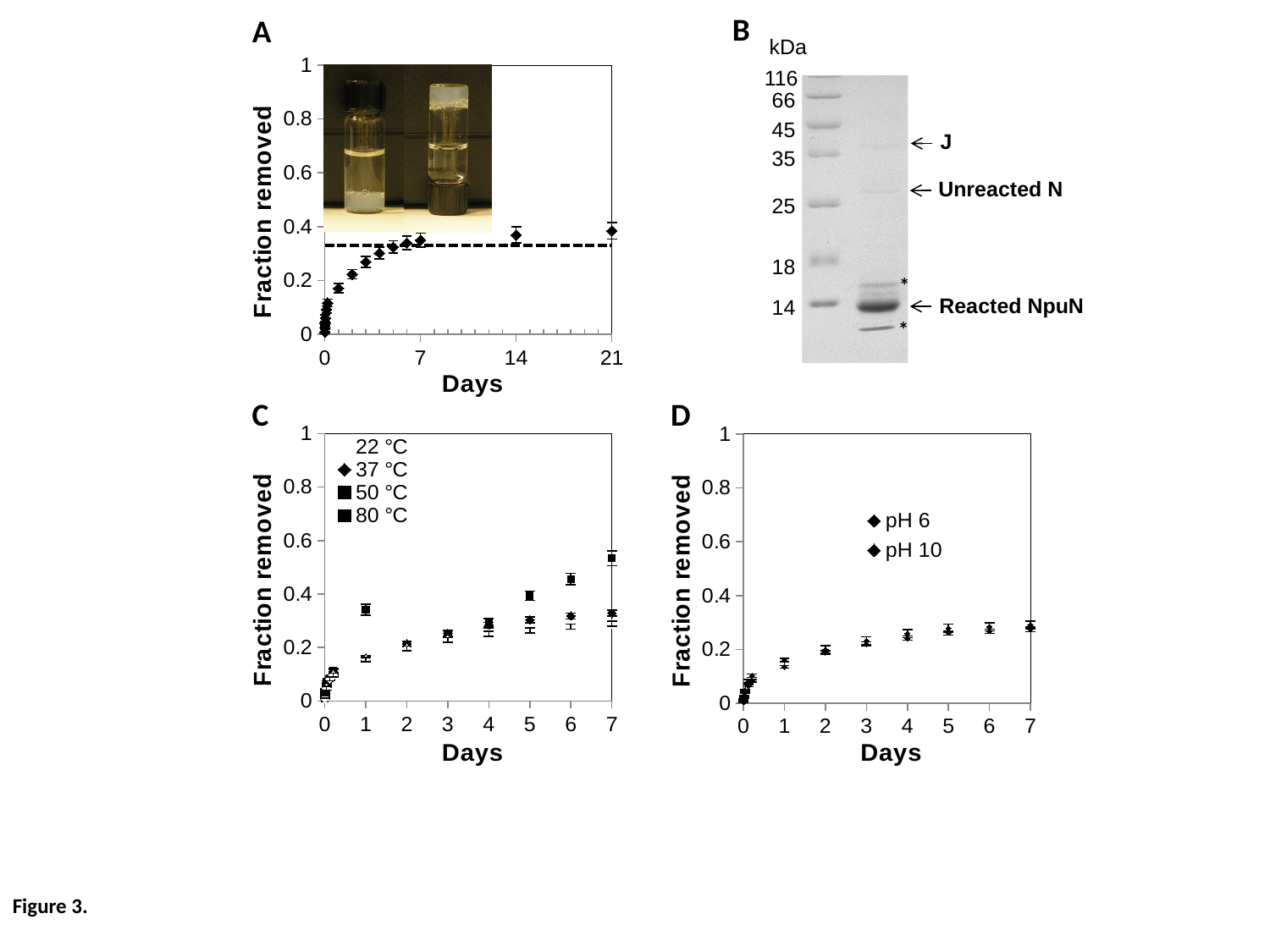
How many series does the legend of chart C (bottom left) list? 4 In chart C (bottom left), which temperatures are listed in the legend? 22 °C, 37 °C, 50 °C, 80 °C In chart A (top left), what is the label of the y axis? Fraction removed In chart A (top left), do the plotted values rise or fall as the number of days increases? rise In chart C (bottom left), do the plotted values generally rise or fall from day 0 to day 7? rise In chart C (bottom left), is the highest fraction removed at day 7 greater or less than 0.4? greater In chart A (top left), what is the largest value shown on the x axis (Days)? 21 In chart A (top left), is the fraction removed at day 14 greater or less than 0.6? less In chart D (bottom right), do the plotted values rise or fall as the number of days increases? rise In chart D (bottom right), is the fraction removed at day 7 greater or less than 0.4? less How many series does the legend of chart D (bottom right) list? 2